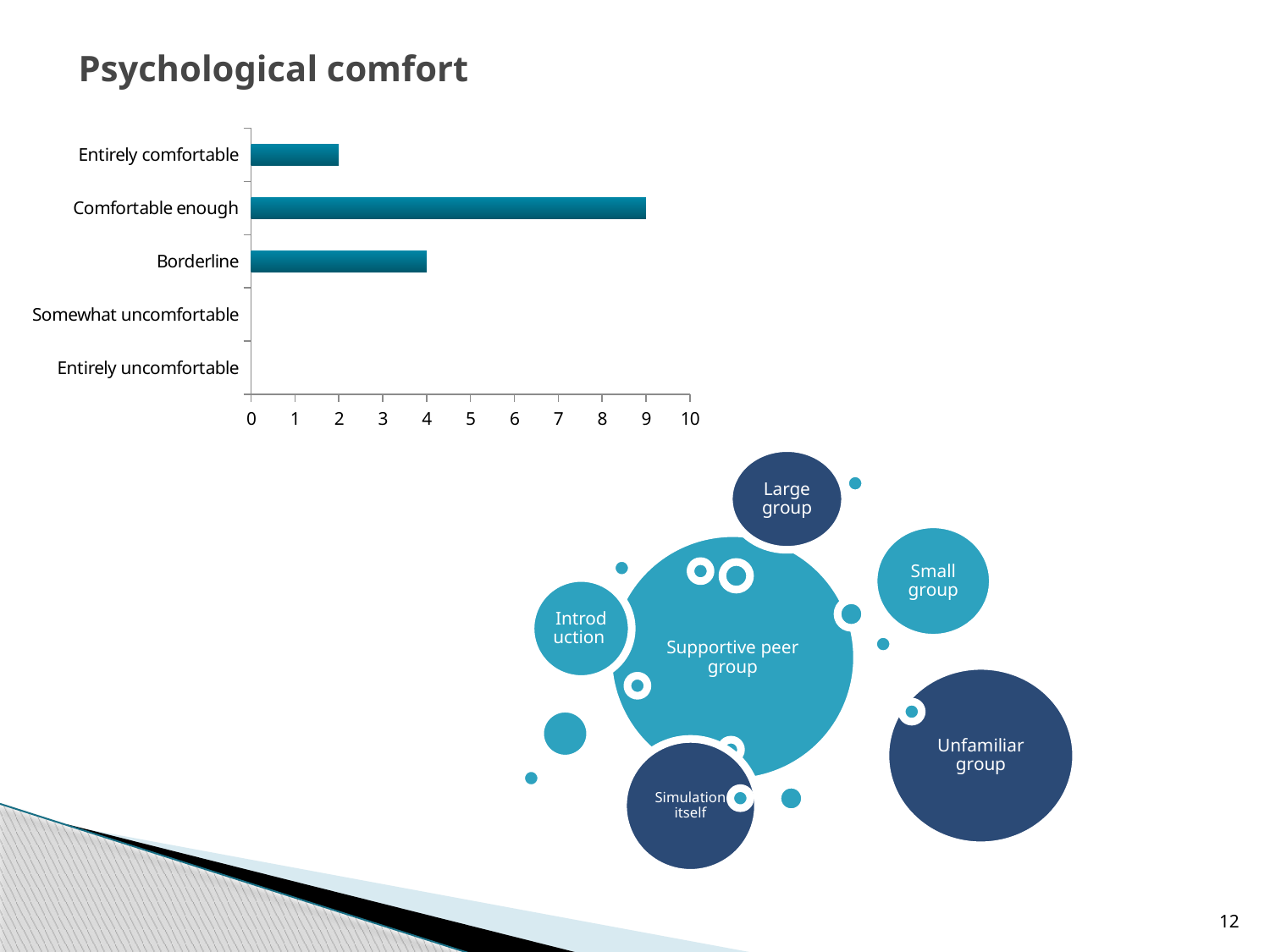
What is the difference between the values for Borderline and Entirely comfortable? 2 What is the title of the slide containing the chart? Psychological comfort What kind of chart is shown on the slide? bar chart Is the value for Comfortable enough greater or less than 5? greater What is the value for Comfortable enough? 9 What is the difference between the values for Comfortable enough and Borderline? 5 What is the value for Borderline? 4 Which is larger, the value for Borderline or the value for Entirely comfortable? Borderline Which category has the highest value? Comfortable enough Is the value for Entirely comfortable greater or less than 5? less What is the value for Entirely comfortable? 2 How many categories are shown on the chart? 5